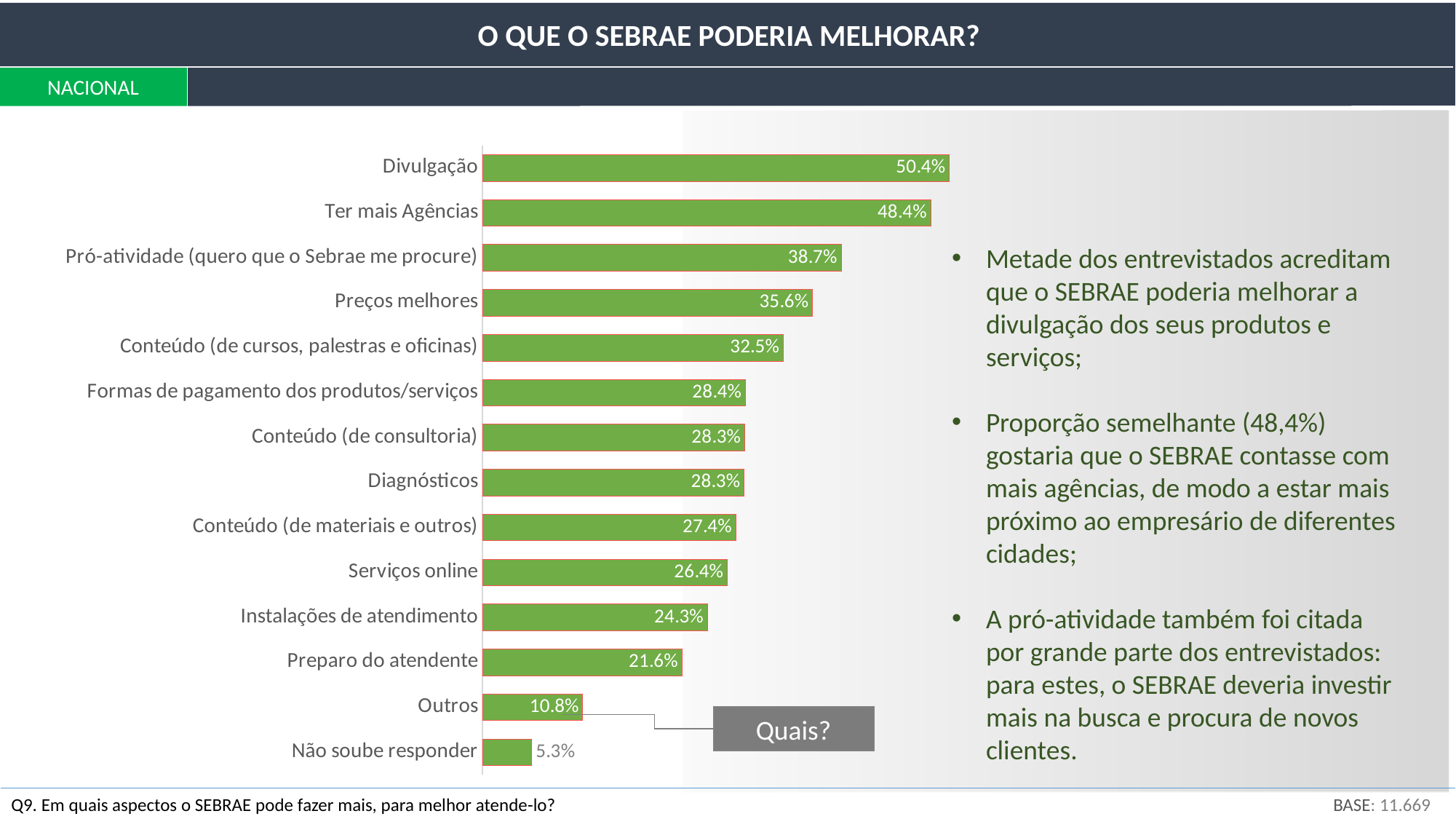
How many categories are shown in the chart? 14 What is the value for Divulgação? 50.4% What is the difference between the values for Divulgação and Ter mais Agências? 2.0% What is the difference between the values for Outros and Não soube responder? 5.5% What is the value for Preços melhores? 35.6% What kind of chart is shown on the slide? Bar chart Which category has the lowest value? Não soube responder What is the value for Ter mais Agências? 48.4% What is the value for Não soube responder? 5.3% Which category has the highest value? Divulgação What is the value for Serviços online? 26.4% Which is larger, the value for Pró-atividade (quero que o Sebrae me procure) or the value for Conteúdo (de cursos, palestras e oficinas)? Pró-atividade (quero que o Sebrae me procure)